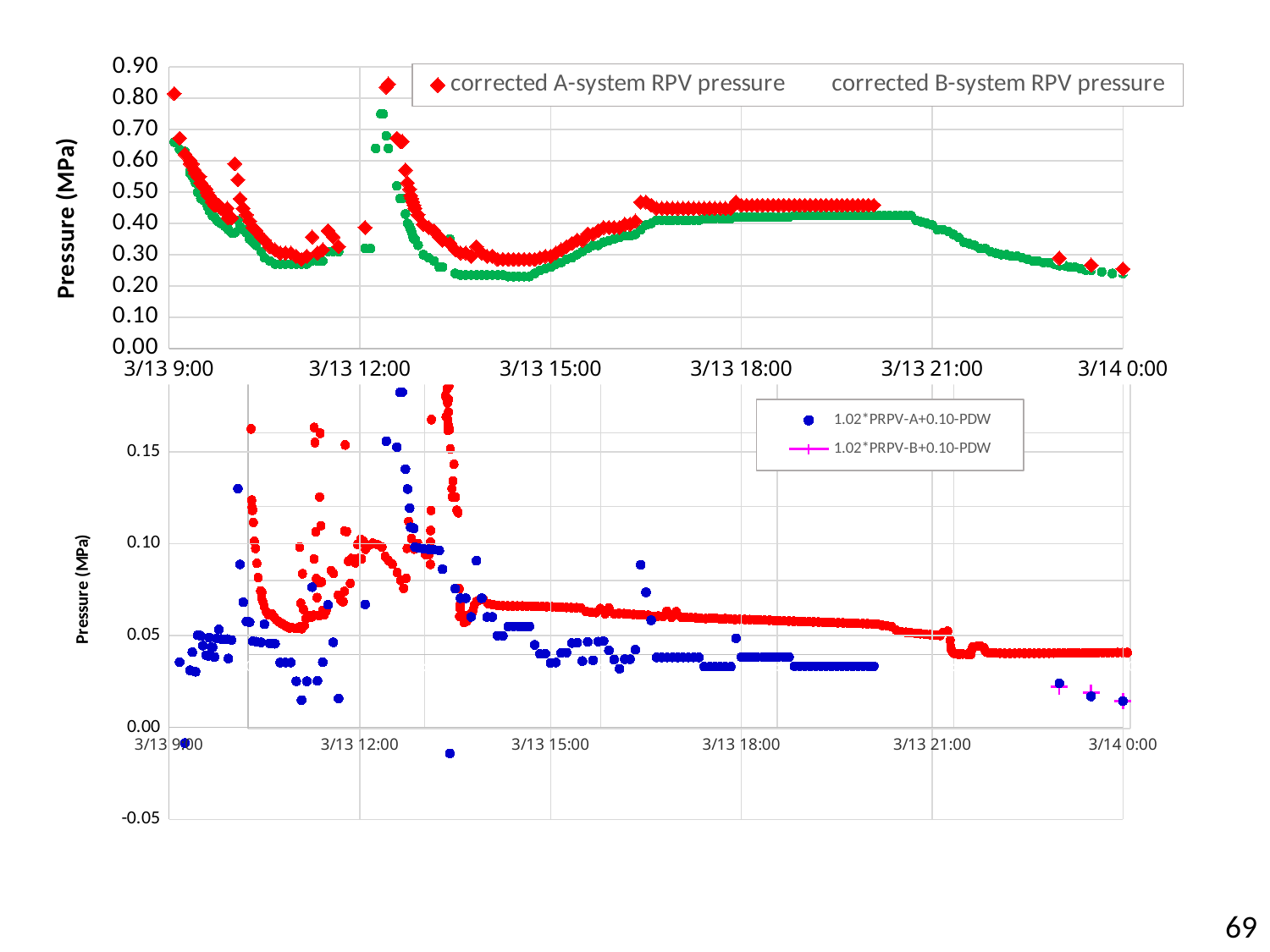
What type of chart is the top chart on the slide? scatter chart In the bottom chart, how many series does the legend list? 2 In the top chart, is the corrected B-system RPV pressure at 3/13 18:00 greater or less than 0.50? less In the top chart, what is the title of the vertical axis? Pressure (MPa) What type of chart is the bottom chart on the slide? scatter chart In the top chart, how many series does the legend list? 2 In the top chart, does the corrected B-system RPV pressure rise or fall between 3/13 21:00 and 3/14 0:00? fall In the bottom chart, what are the two series names shown in the legend? 1.02*PRPV-A+0.10-PDW and 1.02*PRPV-B+0.10-PDW In the top chart, is the corrected B-system RPV pressure at 3/13 15:00 greater or less than 0.30? less In the top chart, is the corrected A-system RPV pressure at 3/14 0:00 greater or less than 0.30? less